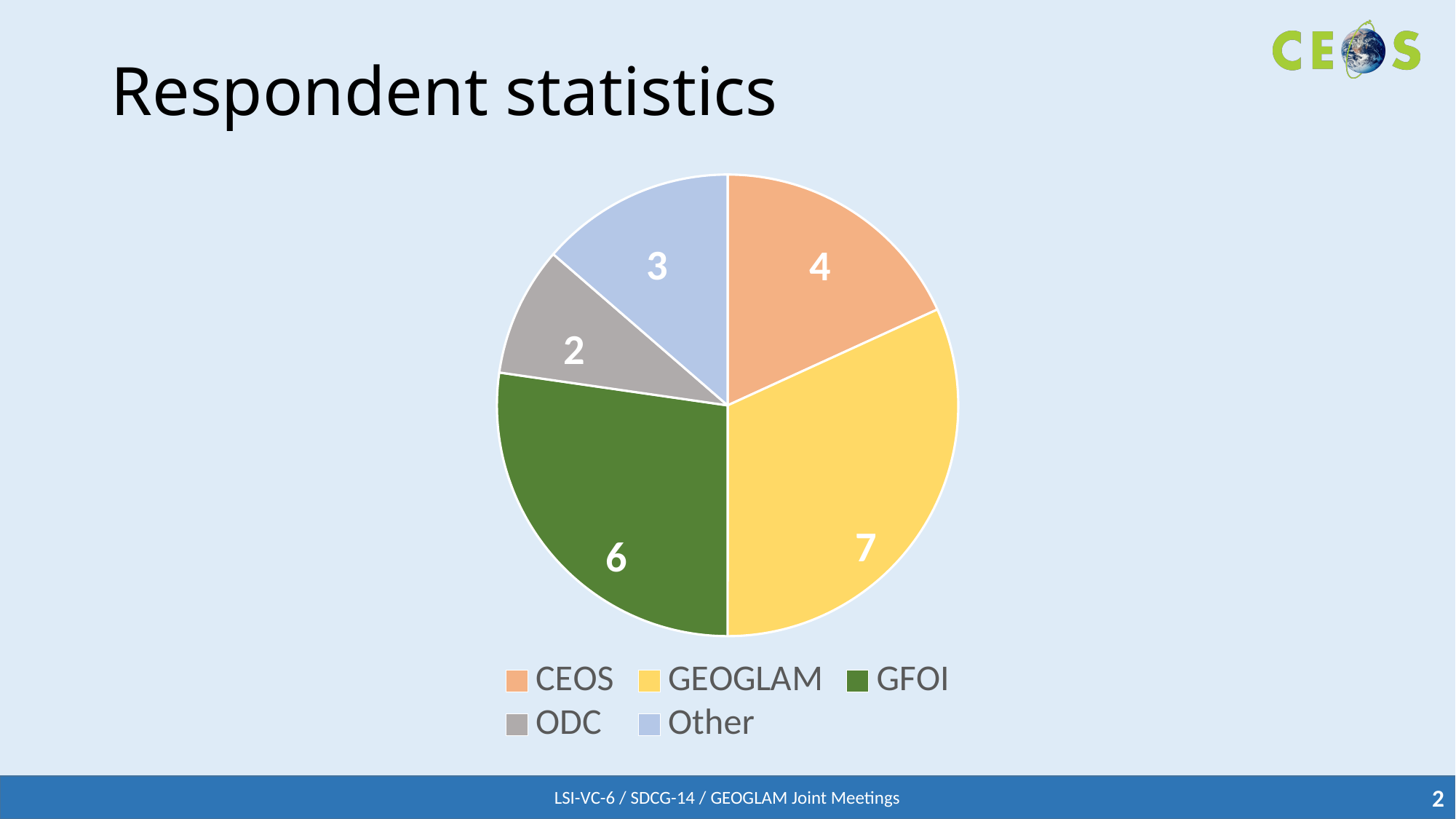
What is the value for CEOS? 4 What is the difference between the GEOGLAM and GFOI values? 1 Which category has the smallest slice? ODC Which category has the largest slice? GEOGLAM What is the value for GEOGLAM? 7 What is the total of all slices in the pie chart? 22 Which is larger, the value for CEOS or the value for Other? CEOS What type of chart is shown on the slide? pie chart How many categories does the pie chart have? 5 What is the value for ODC? 2 What is the title of the slide containing the chart? Respondent statistics What is the value for Other? 3